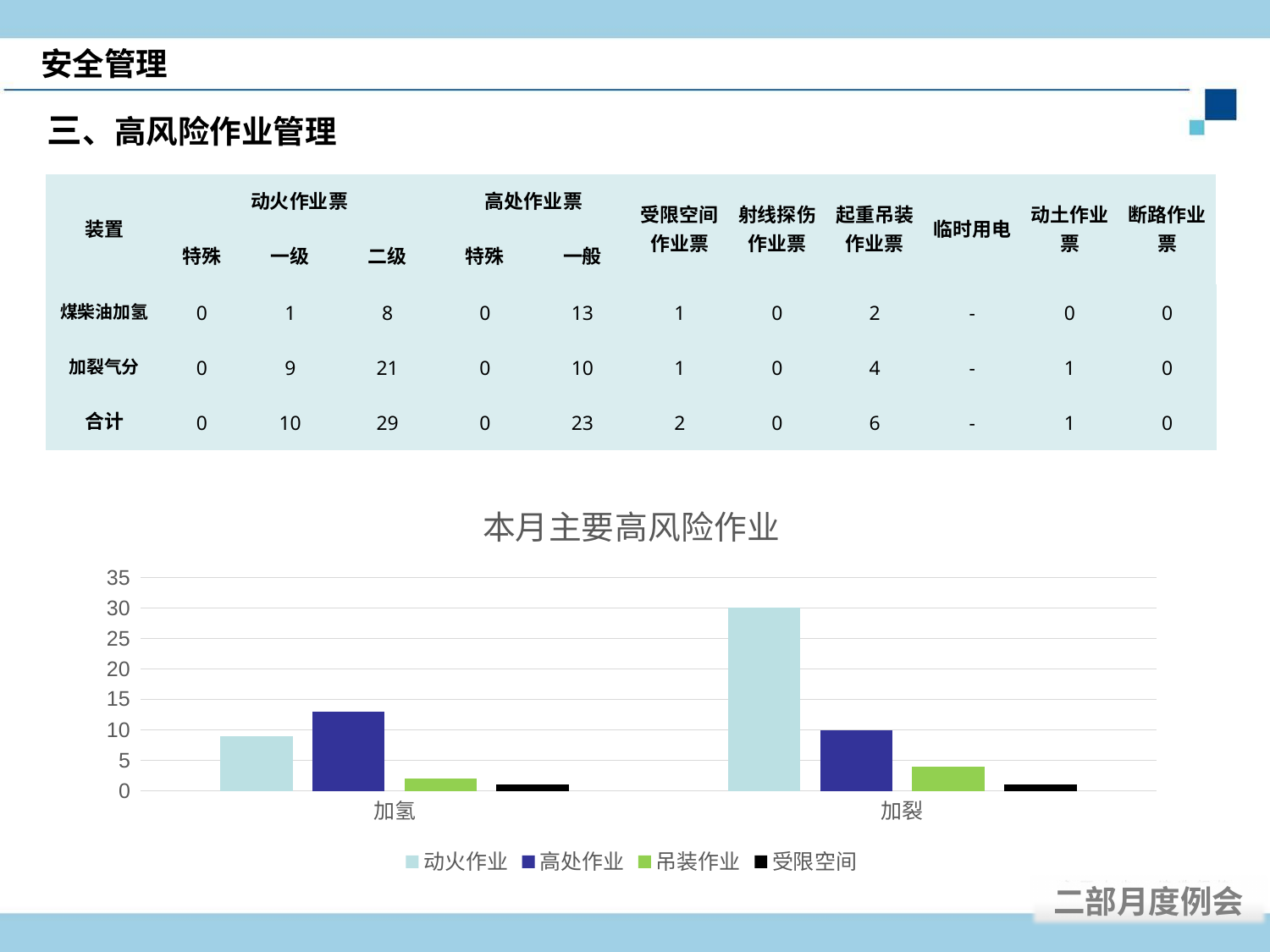
In the 本月主要高风险作业 chart, what is the value of 动火作业 for 加裂? 30 In the 本月主要高风险作业 chart, which is larger: 动火作业 for 加氢 or 动火作业 for 加裂? 动火作业 for 加裂 In the 本月主要高风险作业 chart, what is the value of 高处作业 for 加裂? 10 In the 本月主要高风险作业 chart, which series is shown in black? 受限空间 In the 本月主要高风险作业 chart, is the value of 高处作业 for 加氢 greater or less than 10? greater How many series does the legend of the 本月主要高风险作业 chart list? 4 In the 本月主要高风险作业 chart, which series has the highest bar for 加氢? 高处作业 In the 本月主要高风险作业 chart, which series has the highest bar for 加裂? 动火作业 In the 本月主要高风险作业 chart, is the value of 动火作业 for 加氢 greater or less than 10? less What kind of chart is shown under the title 本月主要高风险作业? bar chart In the 本月主要高风险作业 chart, is the value of 吊装作业 for 加裂 greater or less than 5? less How many categories are shown on the x axis of the 本月主要高风险作业 chart? 2